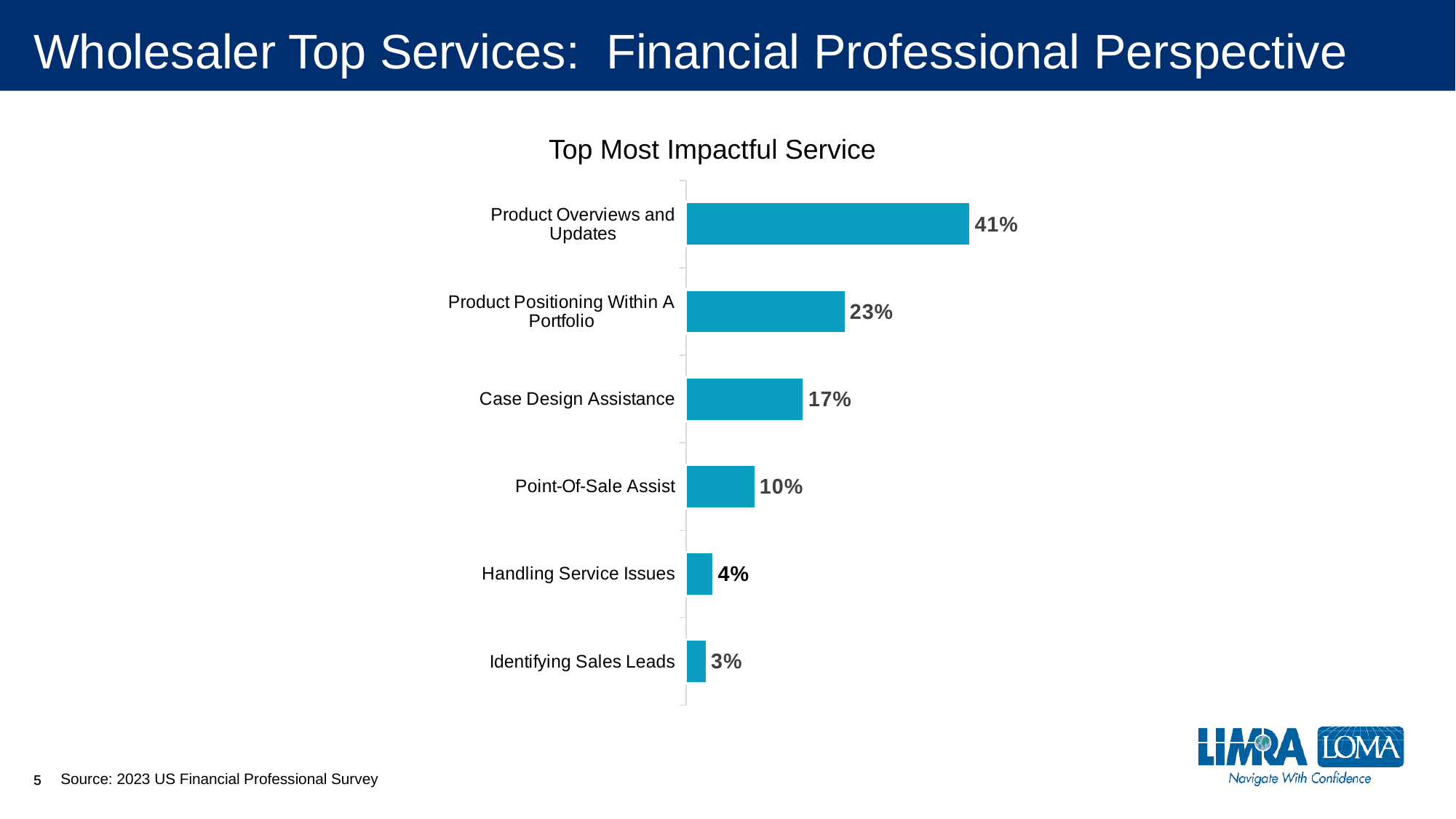
What is the difference between Product Overviews and Updates and Product Positioning Within A Portfolio? 18% Which service has the lowest value? Identifying Sales Leads What is the value for Point-Of-Sale Assist? 10% Which service has the highest value? Product Overviews and Updates What is the difference between Case Design Assistance and Point-Of-Sale Assist? 7% How many services are shown in the chart? 6 What is the value for Product Overviews and Updates? 41% Which is larger, Product Positioning Within A Portfolio or Case Design Assistance? Product Positioning Within A Portfolio What is the value for Case Design Assistance? 17% What is the value for Handling Service Issues? 4% What kind of chart is shown on the slide? Bar chart What is the title of the chart? Top Most Impactful Service